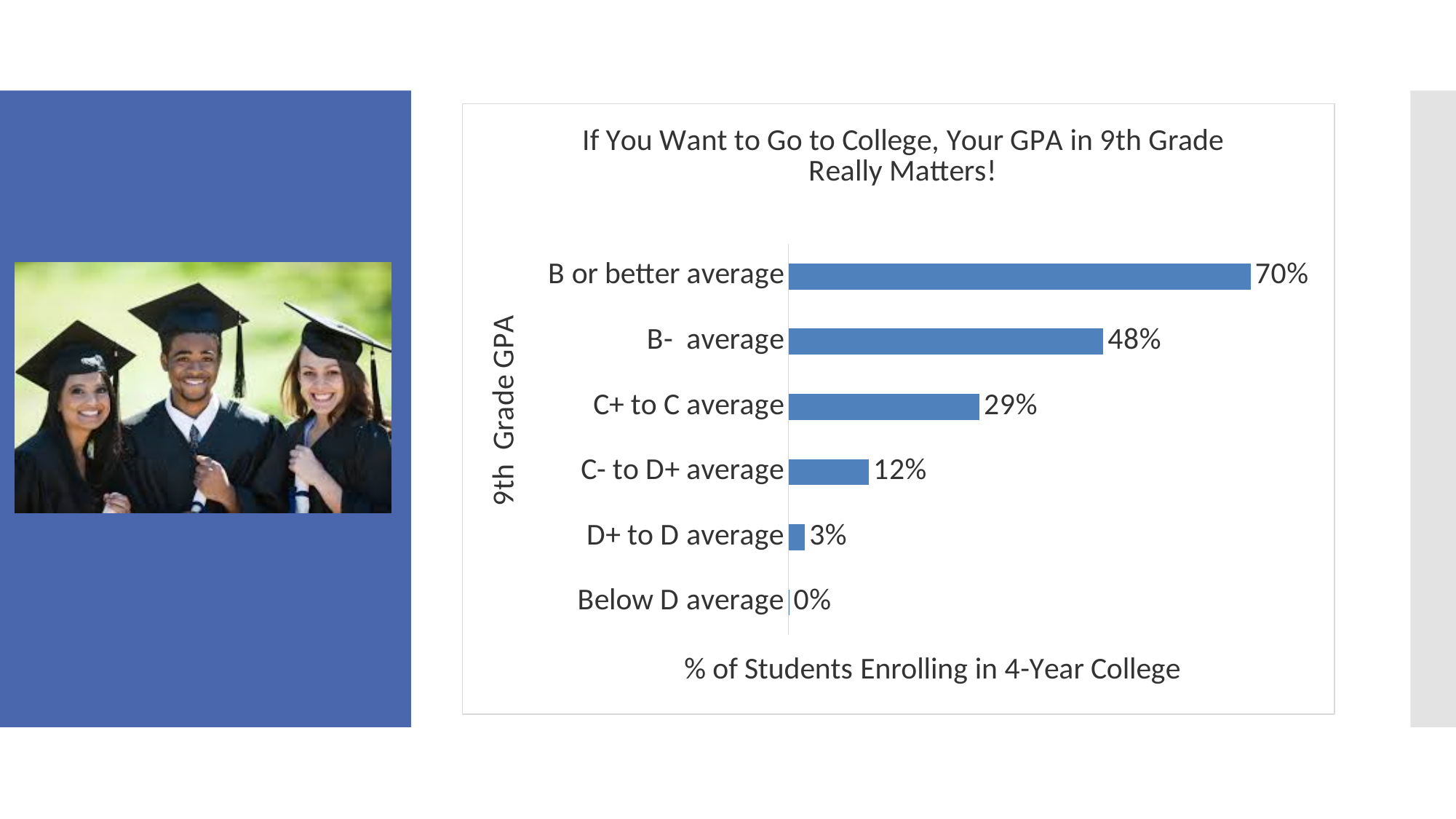
What is the difference between the values for B or better average and B- average? 22% What is the difference between the values for C+ to C average and C- to D+ average? 17% Which GPA category has the lowest percentage of students enrolling in a 4-year college? Below D average What is the value for the D+ to D average category? 3% What percentage of students with a B or better average enroll in a 4-year college? 70% Which is larger, the value for B- average or the value for C+ to C average? B- average What is the value for the C+ to C average category? 29% What is the value for the Below D average category? 0% Which GPA category has the highest percentage of students enrolling in a 4-year college? B or better average How many GPA categories are shown in the chart? 6 What is the label of the horizontal axis of the chart? % of Students Enrolling in 4-Year College What kind of chart is shown on the slide? Bar chart